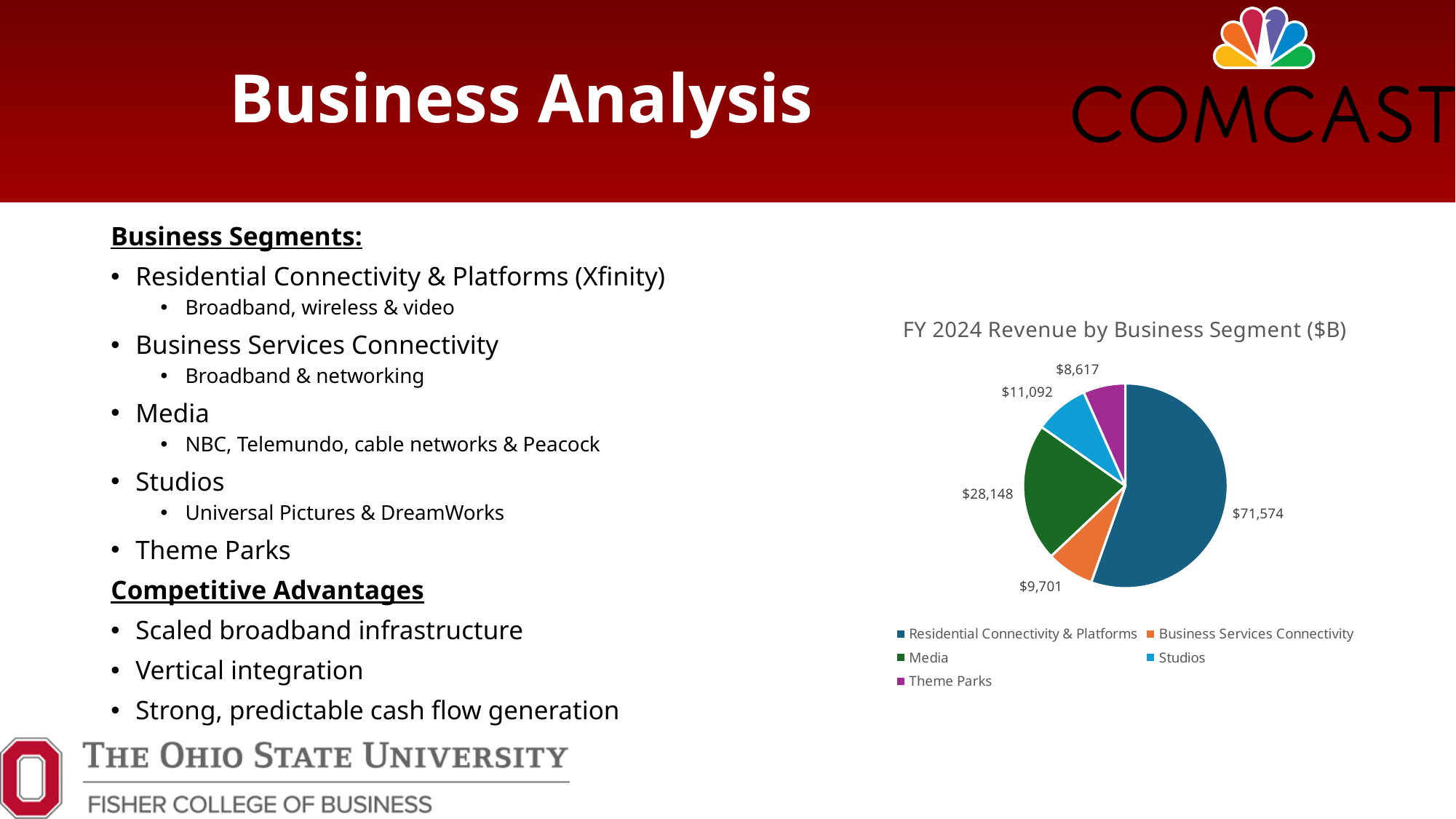
What is the difference between the revenue for Residential Connectivity & Platforms and Media? $43,426 Which business segment has the smallest revenue in the chart? Theme Parks What type of chart is shown on the slide? Pie chart What is the revenue value shown for Studios? $11,092 What is the revenue value shown for Theme Parks? $8,617 Which business segment has the largest revenue in the chart? Residential Connectivity & Platforms What is the revenue value shown for Residential Connectivity & Platforms? $71,574 What is the title of the chart? FY 2024 Revenue by Business Segment ($B) Which has the larger revenue, Studios or Business Services Connectivity? Studios How many business segments are shown in the pie chart? 5 What is the revenue value shown for Media? $28,148 What is the difference between the revenue for Studios and Theme Parks? $2,475